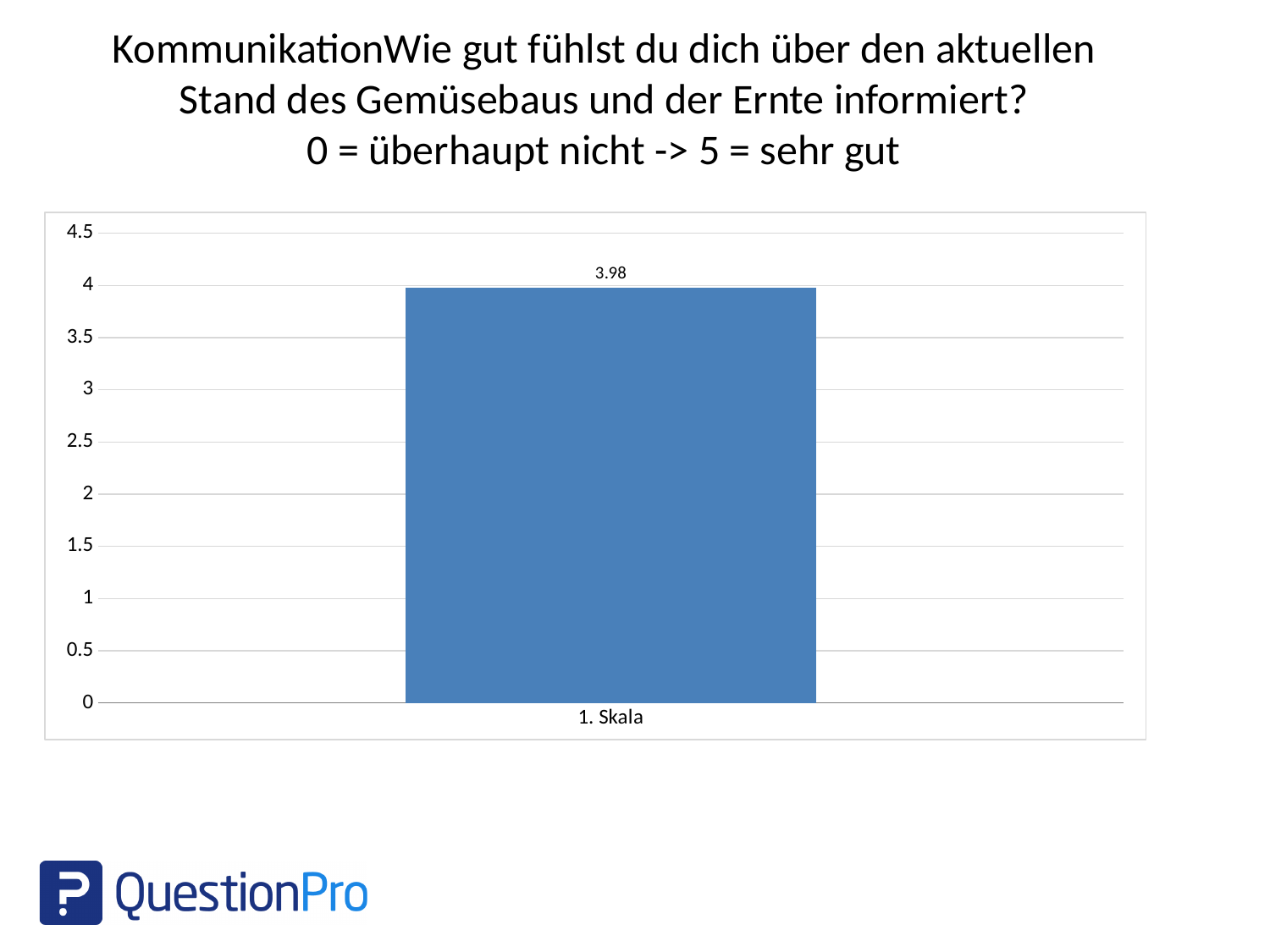
What is the highest value shown on the y axis? 4.5 How many bars are plotted in the chart? 1 What is the lowest value shown on the y axis? 0 Is the value for "1. Skala" greater or less than 3.5? greater Is the value for "1. Skala" greater or less than 4? less What is the label of the category on the x axis? 1. Skala What is the value shown for "1. Skala"? 3.98 What kind of chart is shown on the slide? bar chart